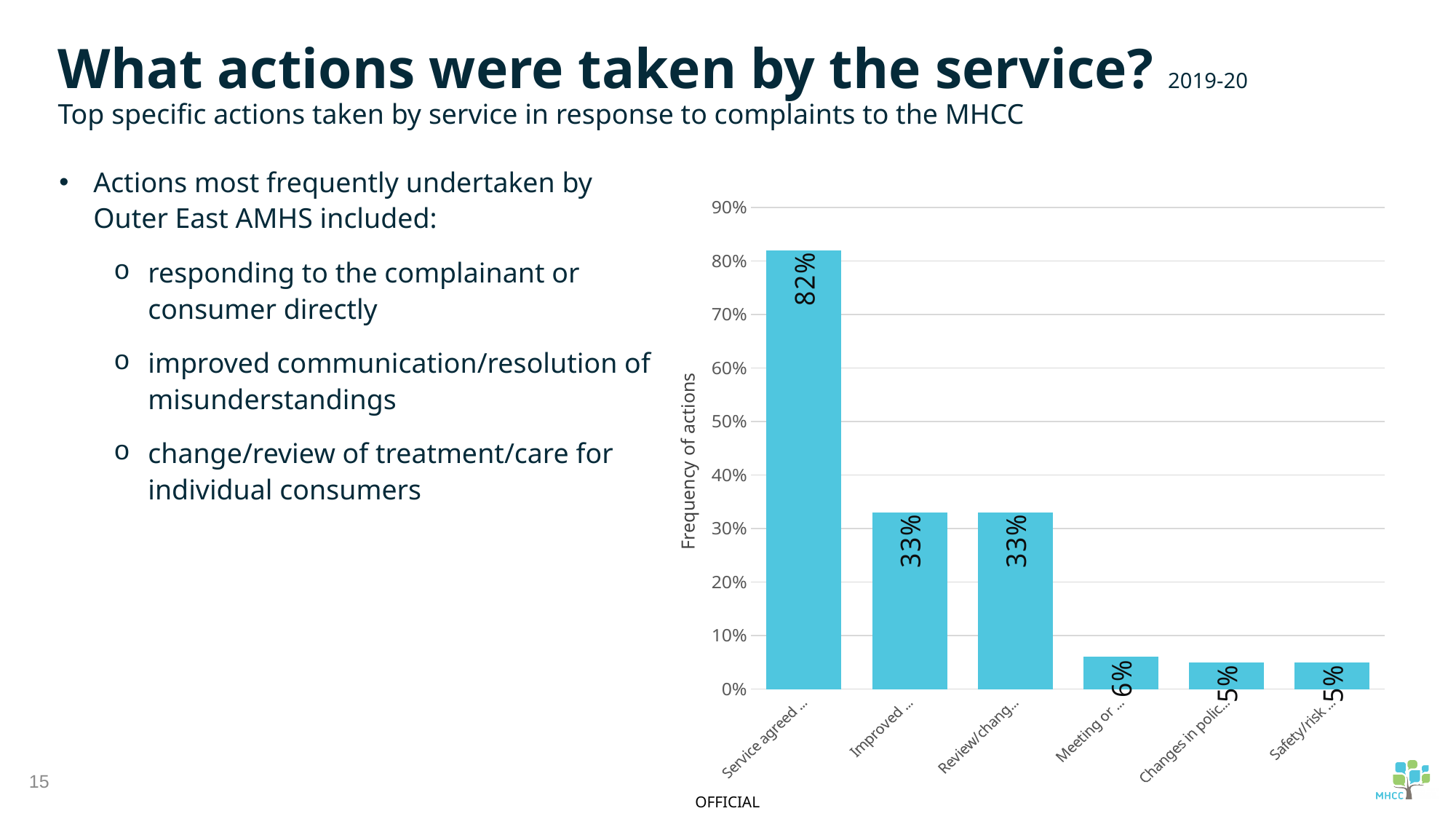
Which is larger, the value for "Review/chang..." or the value for "Meeting or ..."? Review/chang... How many categories (bars) are plotted in the chart? 6 Which category has the highest frequency of actions? Service agreed ... What is the label on the vertical axis of the chart? Frequency of actions What kind of chart is shown on the slide? bar chart What is the value of the first bar, labelled "Service agreed ..."? 82% What is the value of the bar labelled "Meeting or ..."? 6% What is the value of the bar labelled "Improved ..."? 33% What is the value of the bar labelled "Review/chang..."? 33% What is the value of the bar labelled "Changes in polic..."? 5% Is the value for "Safety/risk ..." greater or less than 10%? less What is the difference between the "Service agreed ..." bar and the "Improved ..." bar? 49 percentage points